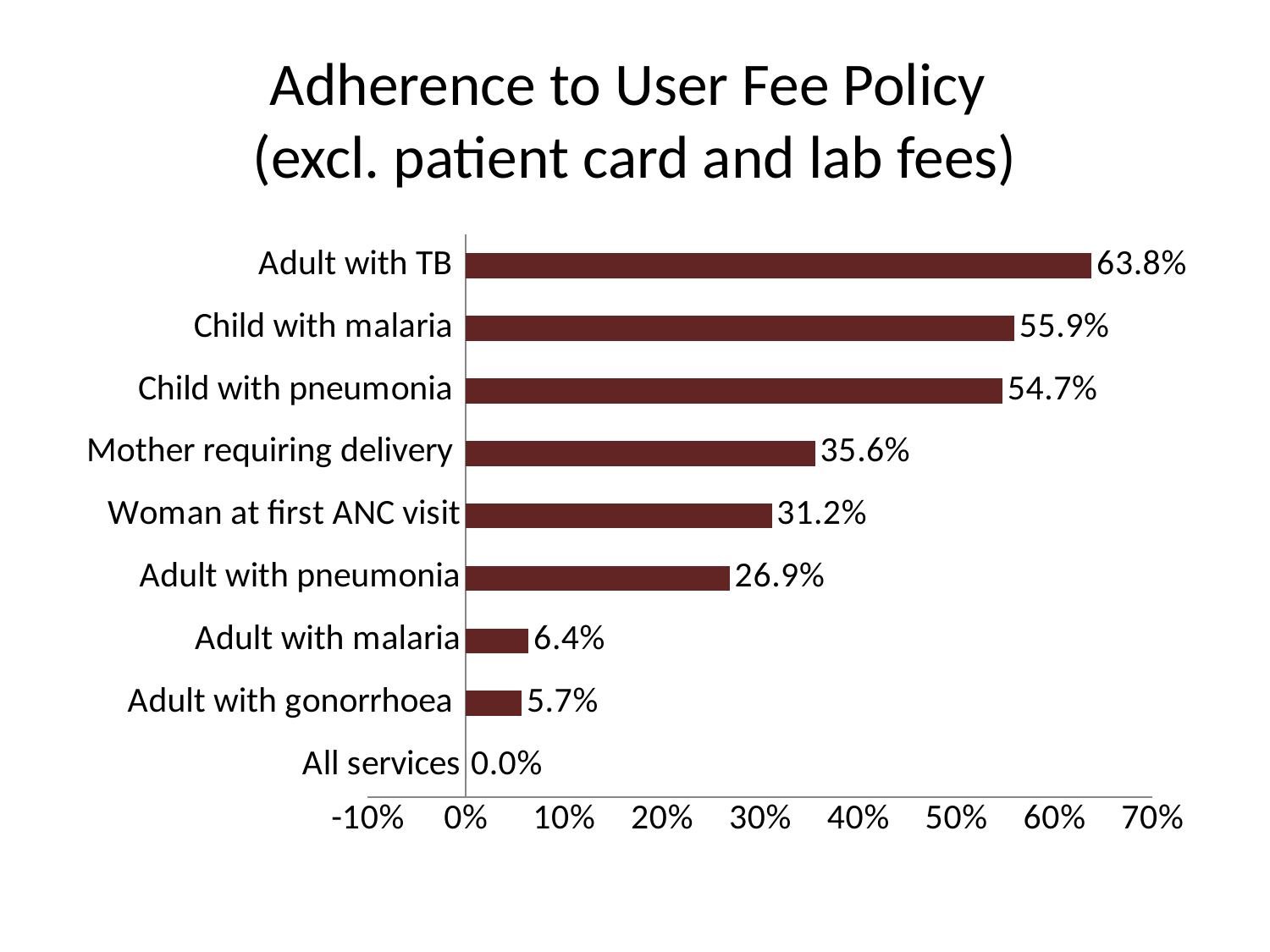
What is the difference between the values for Child with malaria and Child with pneumonia? 1.2% Is the value for Adult with malaria greater or less than 10%? less Which is larger, the value for Woman at first ANC visit or the value for Adult with pneumonia? Woman at first ANC visit What kind of chart is shown on the slide? bar chart How many categories are shown in the chart? 9 What is the adherence value for Adult with TB? 63.8% What is the difference between the values for Adult with TB and All services? 63.8% What is the title of the chart? Adherence to User Fee Policy (excl. patient card and lab fees) What is the adherence value for Adult with gonorrhoea? 5.7% What is the adherence value for Mother requiring delivery? 35.6% Which category has the highest adherence value? Adult with TB Which category has the lowest adherence value? All services